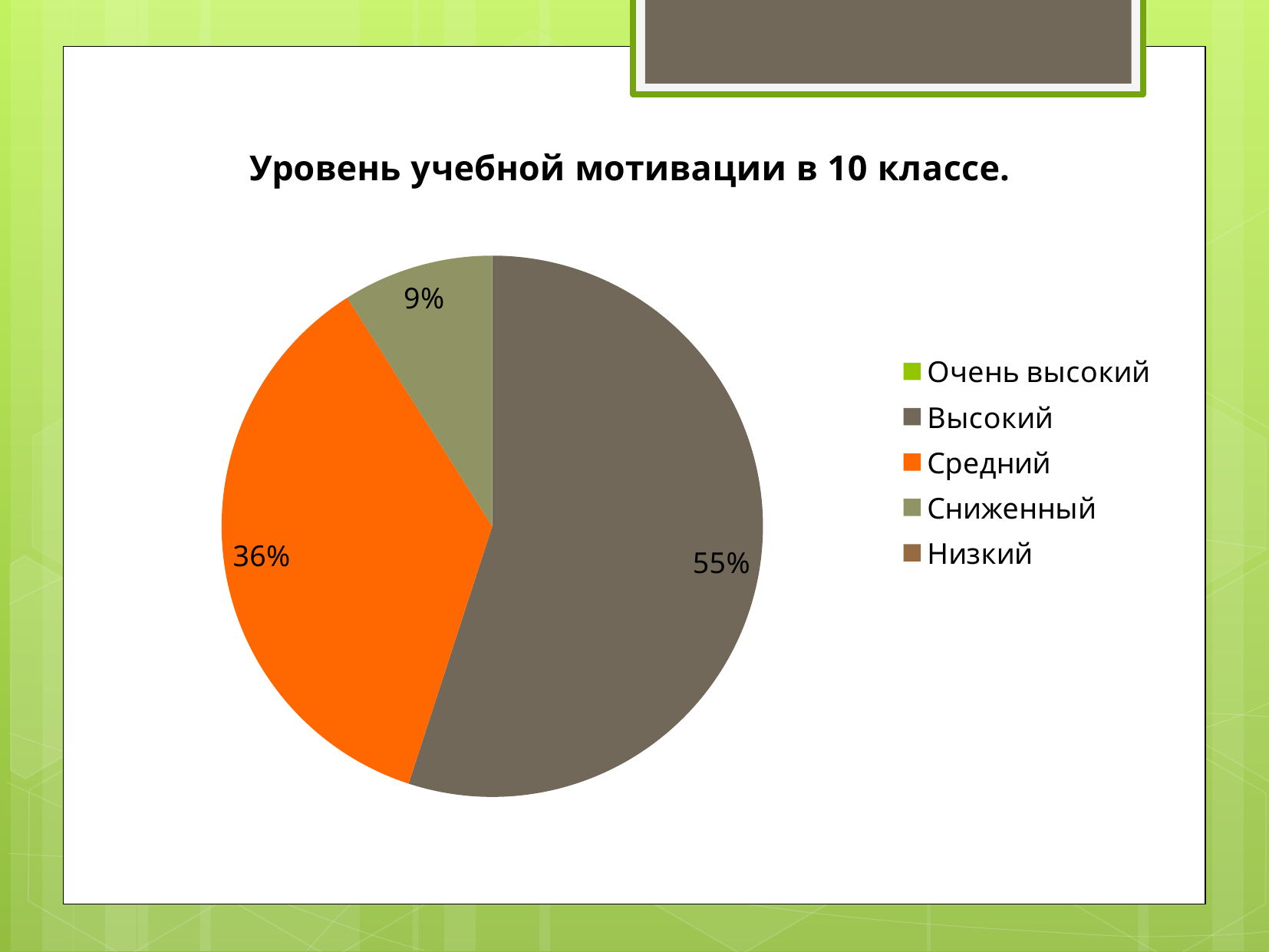
How many slices with data labels are visible in the pie? 3 What is the difference between the Высокий and Средний shares? 19% How many entries does the legend list? 5 What share of the pie does the Высокий slice take? 55% What kind of chart is shown on the slide? pie chart What share of the pie does the Сниженный slice take? 9% What colour is the Средний slice? orange Which is larger, the Средний slice or the Сниженный slice? Средний What is the title of the chart? Уровень учебной мотивации в 10 классе. What share of the pie does the Средний slice take? 36% Which of the labelled slices is the smallest? Сниженный Which category has the largest slice of the pie? Высокий